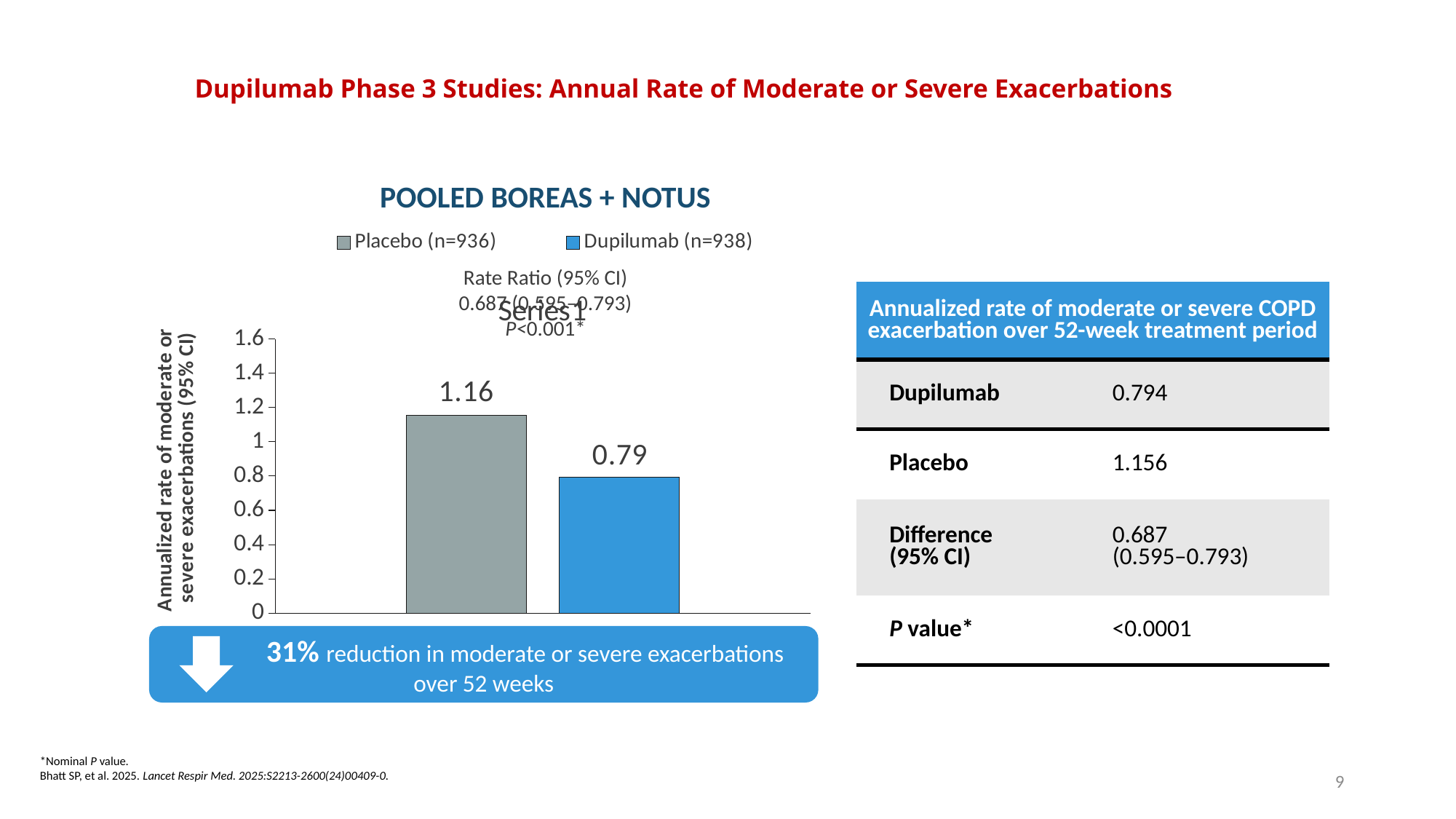
Which series has the lowest bar in the chart? Dupilumab (n=938) Which group has the higher annualized exacerbation rate in the chart, Placebo or Dupilumab? Placebo What is the annualized rate of moderate or severe exacerbations for Placebo (n=936) in the chart? 1.16 What is the title of the chart? POOLED BOREAS + NOTUS What is the difference between the Placebo and Dupilumab bar values in the chart? 0.37 Is the value for Placebo (n=936) greater or less than 1? greater Is the value for Dupilumab (n=938) greater or less than 1? less What kind of chart is shown on the slide? Bar chart What is the annualized rate of moderate or severe exacerbations for Dupilumab (n=938) in the chart? 0.79 How many series does the chart legend list? 2 How many bars are plotted in the chart? 2 Which series has the highest bar in the chart? Placebo (n=936)